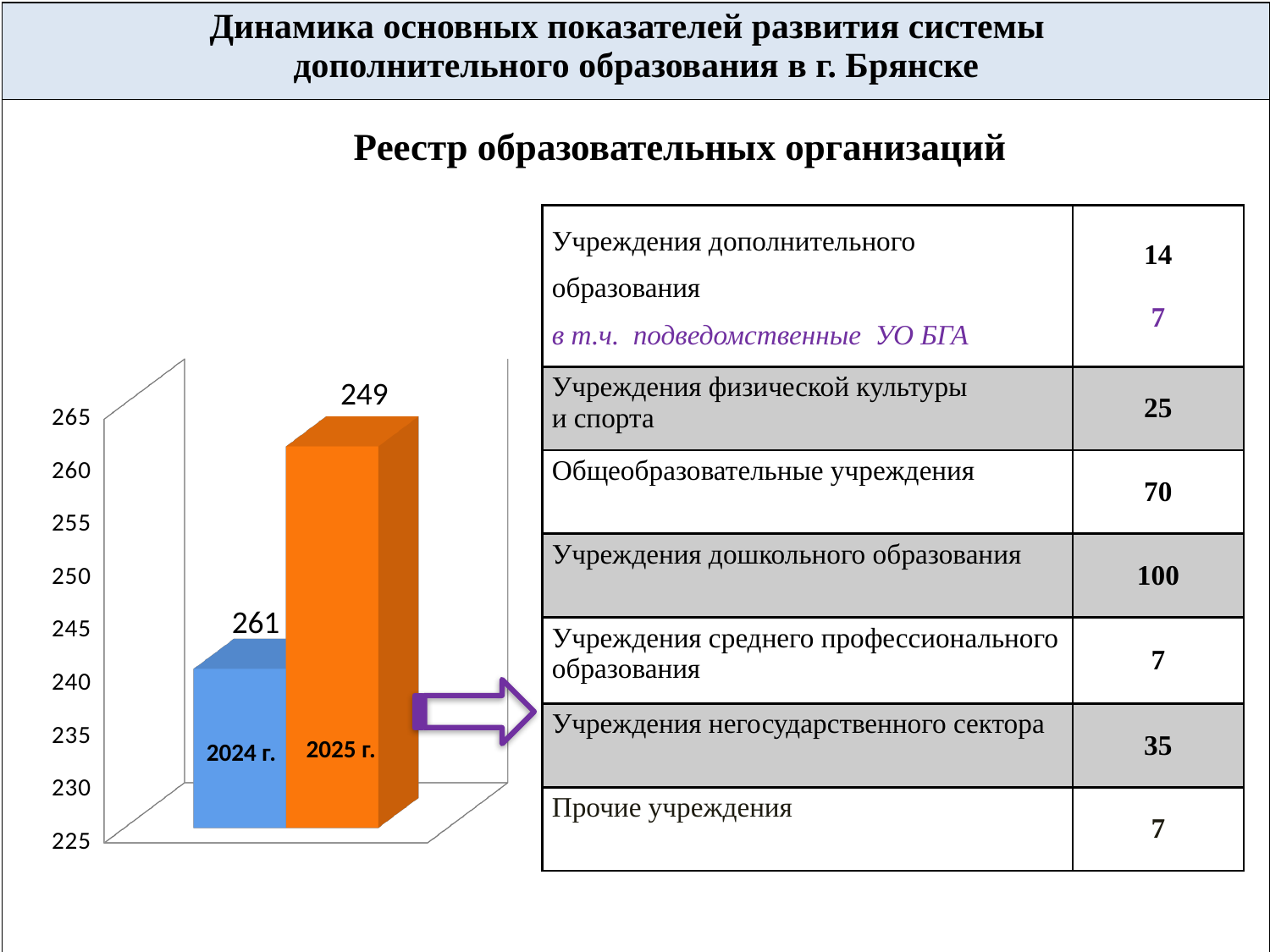
What kind of chart is shown on the slide? bar chart What is the difference between the labelled values for 2024 г. and 2025 г.? 12 What colour is the bar for 2025 г.? orange What colour is the bar for 2024 г.? blue How many bars (categories) are shown in the chart? 2 What value is labelled on the bar for 2025 г.? 249 What value is labelled on the bar for 2024 г.? 261